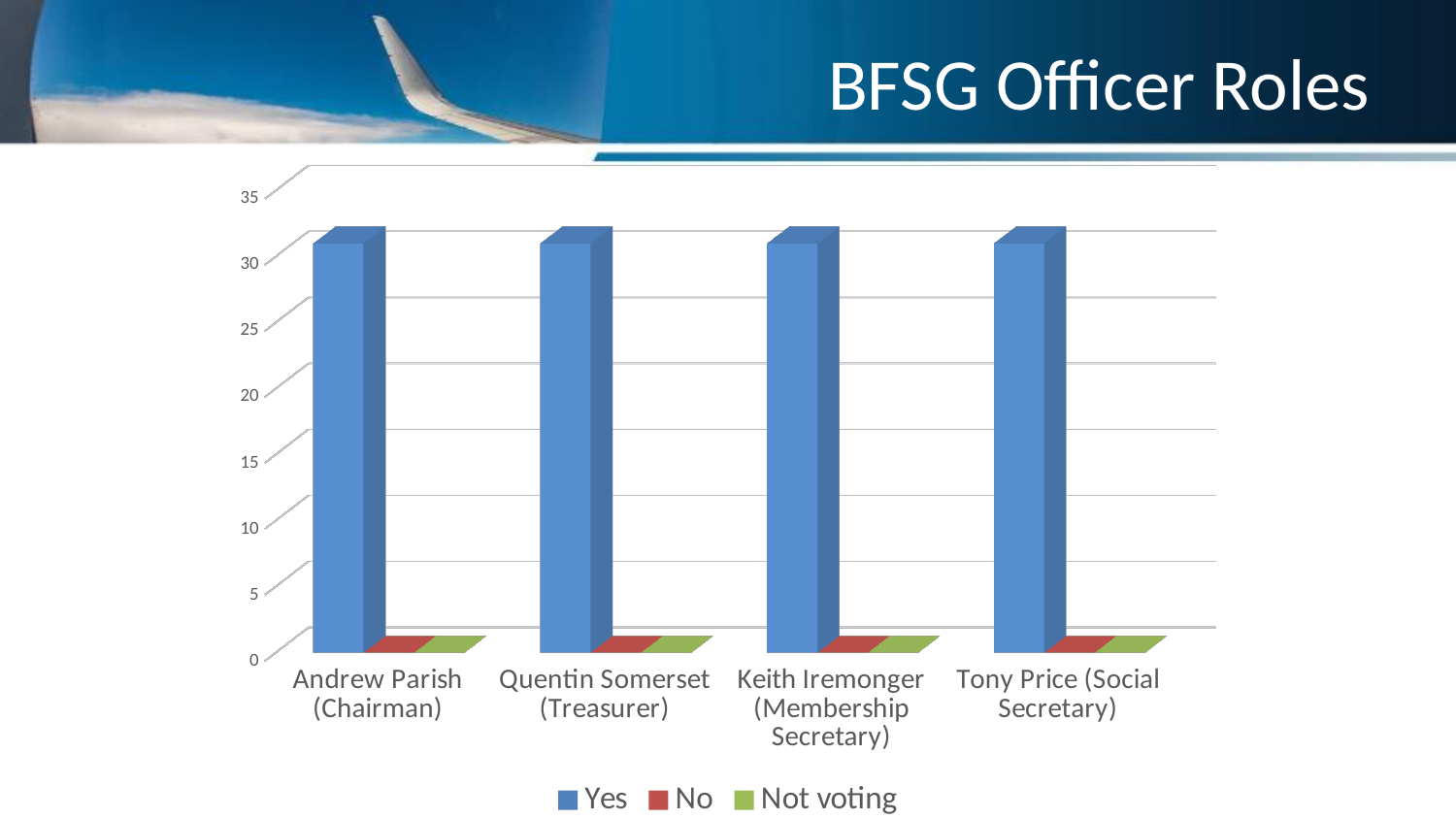
For Tony Price (Social Secretary), which is larger: the 'Yes' value or the 'No' value? Yes Which colour represents the 'Not voting' series in the legend? green Is the 'Yes' value for Quentin Somerset (Treasurer) greater or less than 35? less For Keith Iremonger (Membership Secretary), which is larger: the 'Yes' value or the 'Not voting' value? Yes What kind of chart is shown on the slide? bar chart How many officer candidates (categories) are shown on the x axis? 4 How many series does the legend list? 3 What is the title of the slide containing the chart? BFSG Officer Roles Is the 'Yes' value for Tony Price (Social Secretary) greater or less than 35? less Is the 'No' value for Andrew Parish (Chairman) greater or less than 5? less